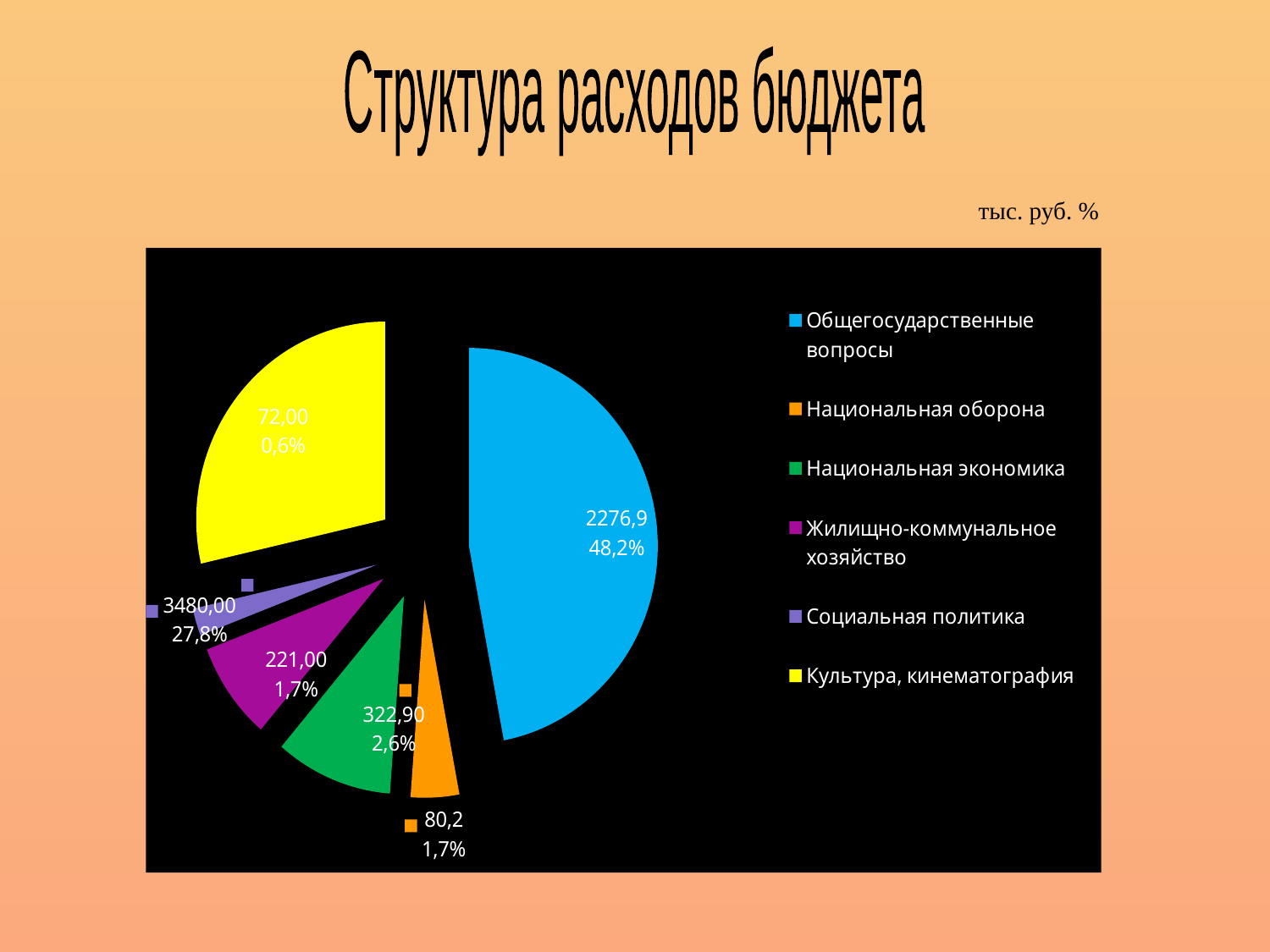
How many slices does the pie chart have? 6 What value is labelled for Жилищно-коммунальное хозяйство? 221,00 What kind of chart is shown on the slide? pie chart What percentage is labelled for Общегосударственные вопросы? 48,2% What percentage is labelled for Социальная политика? 27,8% What is the title of the chart? Структура расходов бюджета What value is labelled for Национальная оборона? 80,2 What value is labelled on the slice for Общегосударственные вопросы? 2276,9 What value is labelled for Национальная экономика? 322,90 What value is labelled for Культура, кинематография? 72,00 How many categories does the legend list? 6 What percentage is labelled for Национальная экономика? 2,6%